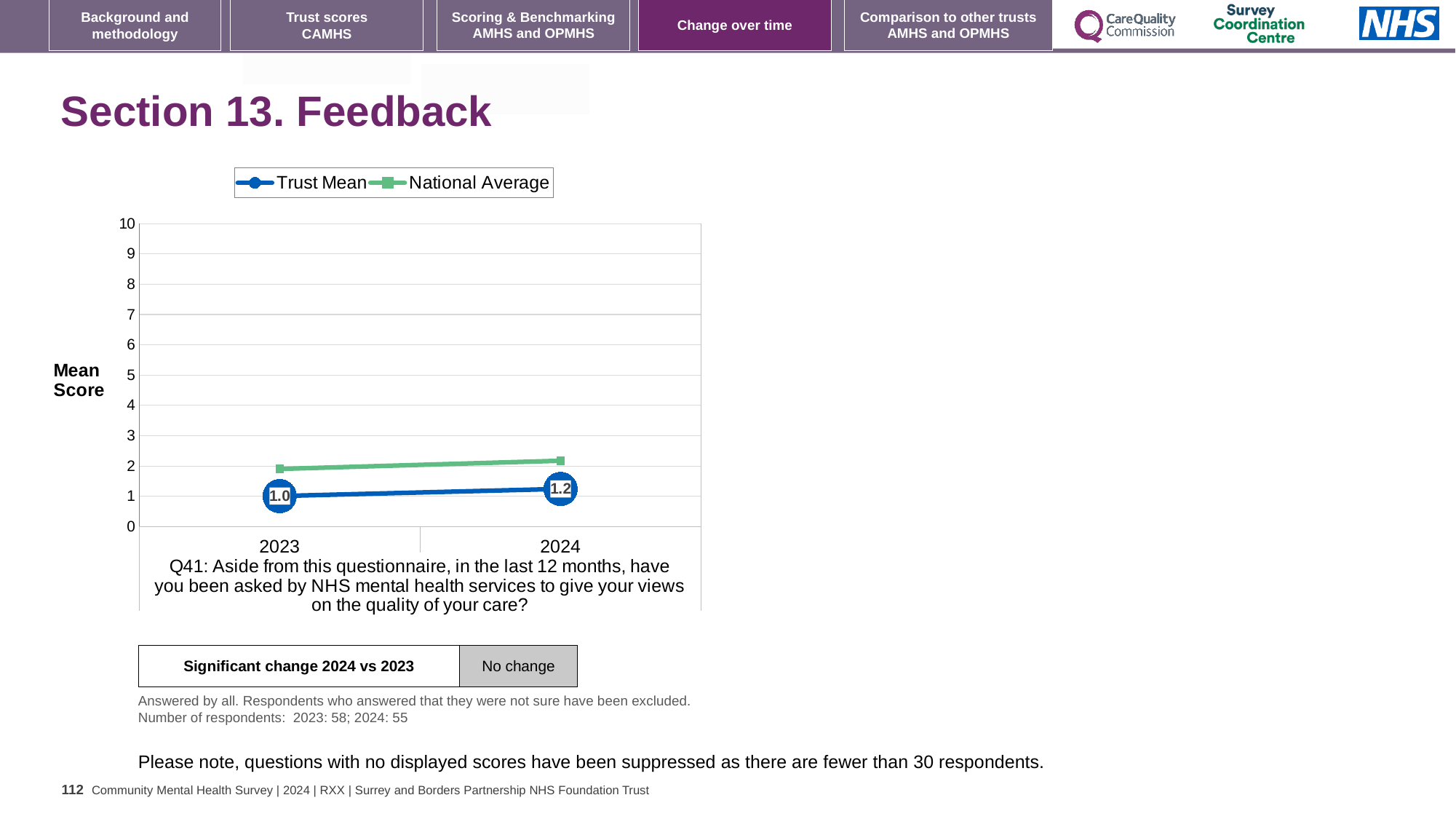
Does the Trust Mean rise or fall from 2023 to 2024? rise What is the Trust Mean value for 2024? 1.2 Is the National Average value for 2023 greater or less than 3? less How many years are plotted on the x axis? 2 Which year has the lowest Trust Mean? 2023 In which year is the Trust Mean higher, 2023 or 2024? 2024 What kind of chart is shown on the slide? line chart What is the Trust Mean value for 2023? 1.0 Is the National Average value for 2024 greater or less than 1? greater How many series does the legend list? 2 In 2024, which is higher, the Trust Mean or the National Average? National Average By how much did the Trust Mean change from 2023 to 2024? 0.2